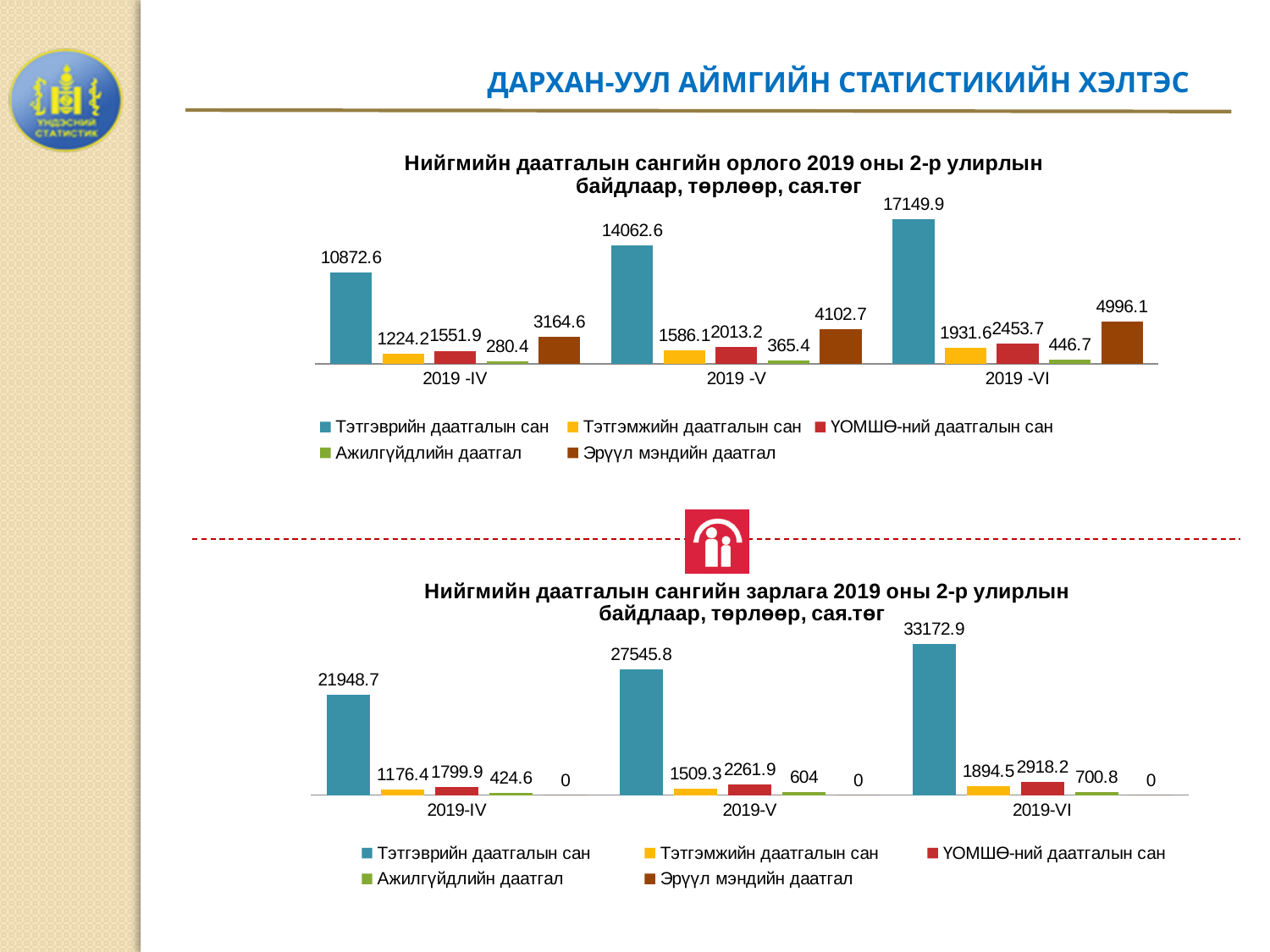
In the top chart (Нийгмийн даатгалын сангийн орлого), which period has the highest value for Тэтгэврийн даатгалын сан? 2019 -VI How many series does the legend of the top chart (Нийгмийн даатгалын сангийн орлого) list? 5 What type of chart is the bottom chart (Нийгмийн даатгалын сангийн зарлага)? bar chart In the top chart (Нийгмийн даатгалын сангийн орлого), what is the value of Тэтгэврийн даатгалын сан for 2019 -VI? 17149.9 In the bottom chart (Нийгмийн даатгалын сангийн зарлага), which is larger: ҮОМШӨ-ний даатгалын сан in 2019-VI or Тэтгэмжийн даатгалын сан in 2019-VI? ҮОМШӨ-ний даатгалын сан In the bottom chart (Нийгмийн даатгалын сангийн зарлага), what is the value of Эрүүл мэндийн даатгал for 2019-VI? 0 In the top chart (Нийгмийн даатгалын сангийн орлого), what is the value of Эрүүл мэндийн даатгал for 2019 -IV? 3164.6 In the top chart (Нийгмийн даатгалын сангийн орлого), what is the difference between Тэтгэврийн даатгалын сан in 2019 -V and 2019 -IV? 3190.0 In the top chart (Нийгмийн даатгалын сангийн орлого), what is the value of Ажилгүйдлийн даатгал for 2019 -V? 365.4 In the top chart (Нийгмийн даатгалын сангийн орлого), does the value of Тэтгэврийн даатгалын сан rise or fall from 2019 -IV to 2019 -VI? rise In the bottom chart (Нийгмийн даатгалын сангийн зарлага), what is the value of Тэтгэврийн даатгалын сан for 2019-V? 27545.8 In the bottom chart (Нийгмийн даатгалын сангийн зарлага), which series has the lowest value in 2019-IV? Эрүүл мэндийн даатгал